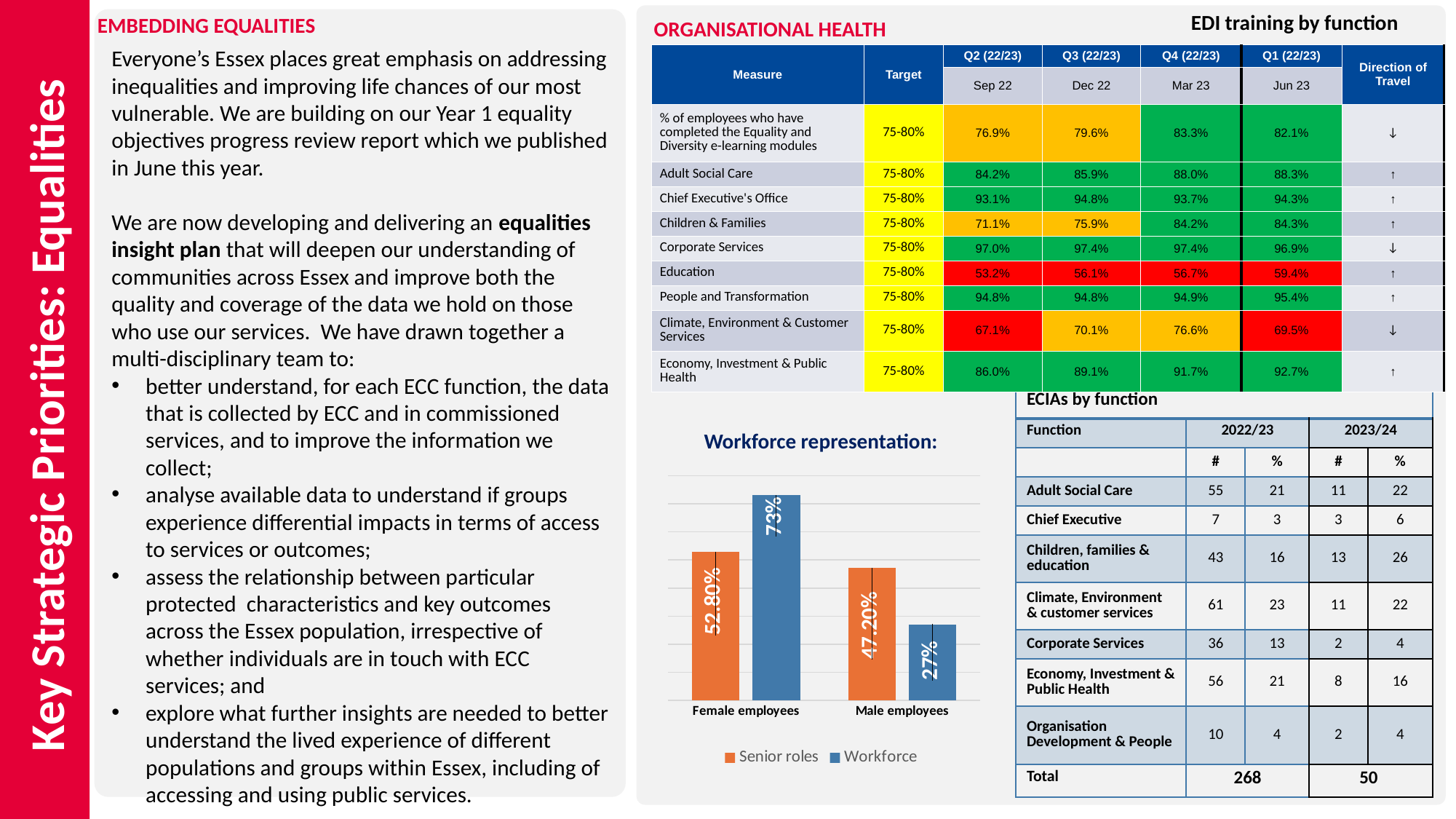
In the Workforce representation chart, which is larger for Female employees: the Senior roles value or the Workforce value? Workforce In the Workforce representation chart, what is the Workforce value for Male employees? 27% In the Workforce representation chart, which category has the highest Workforce value? Female employees In the Workforce representation chart, what is the difference between the Workforce values for Female employees and Male employees? 46% What type of chart is the Workforce representation chart? Bar chart In the Workforce representation chart, which category has the lowest Senior roles value? Male employees In the Workforce representation chart, what is the difference between the Senior roles values for Female employees and Male employees? 5.60% How many categories are shown on the x axis of the Workforce representation chart? 2 In the Workforce representation chart, what is the Workforce value for Female employees? 73% How many series does the legend of the Workforce representation chart list? 2 In the Workforce representation chart, what is the Senior roles value for Female employees? 52.80% In the Workforce representation chart, what is the Senior roles value for Male employees? 47.20%